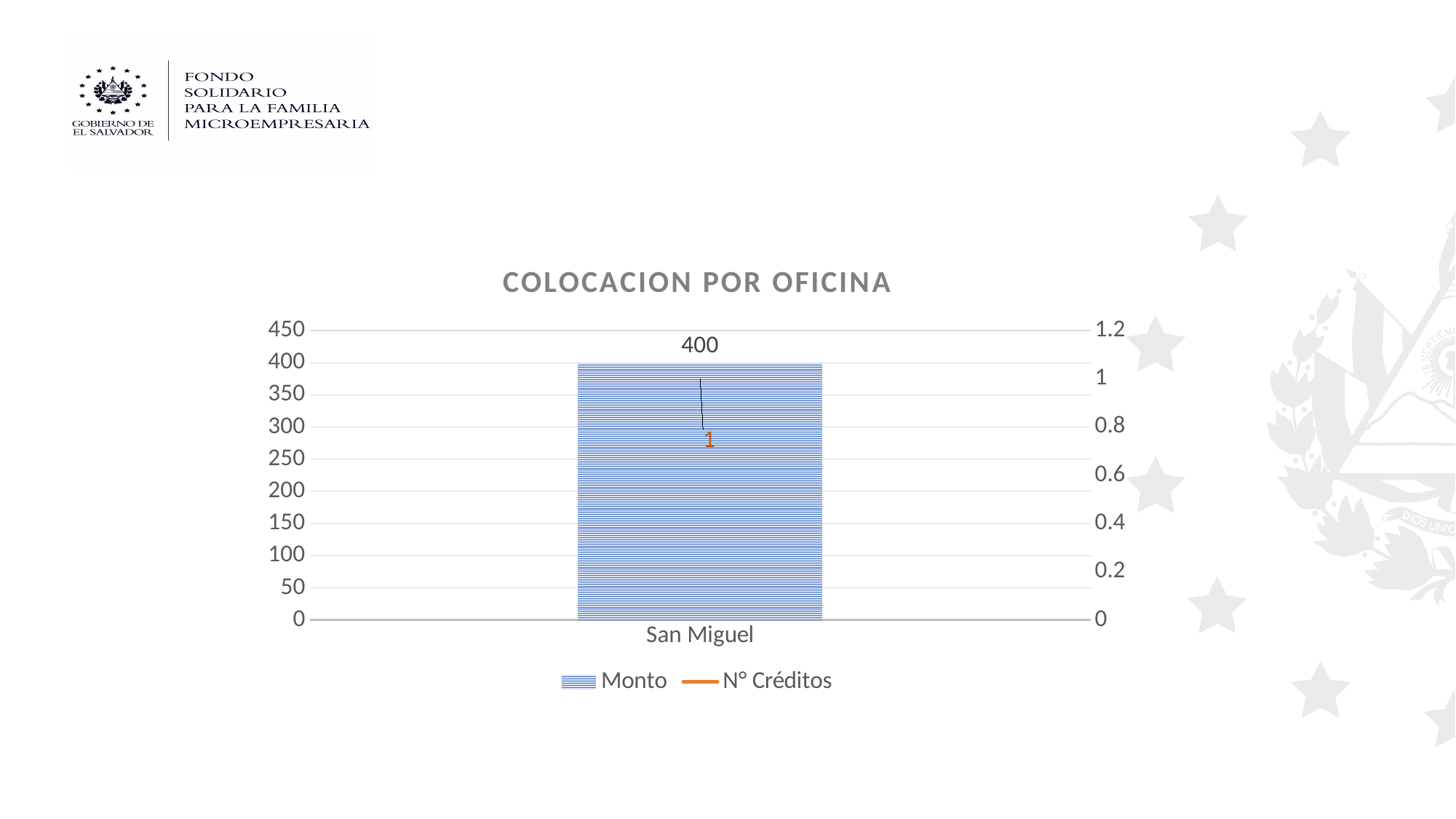
Is the Monto value for San Miguel greater or less than 350? greater How many categories are shown on the x axis? 1 What is the Monto value for San Miguel? 400 Which office is shown on the x axis? San Miguel Which series is shown as a bar? Monto What is the maximum value shown on the left vertical axis? 450 What is the title of the chart? COLOCACION POR OFICINA How many series does the legend list? 2 What is the N° Créditos value for San Miguel? 1